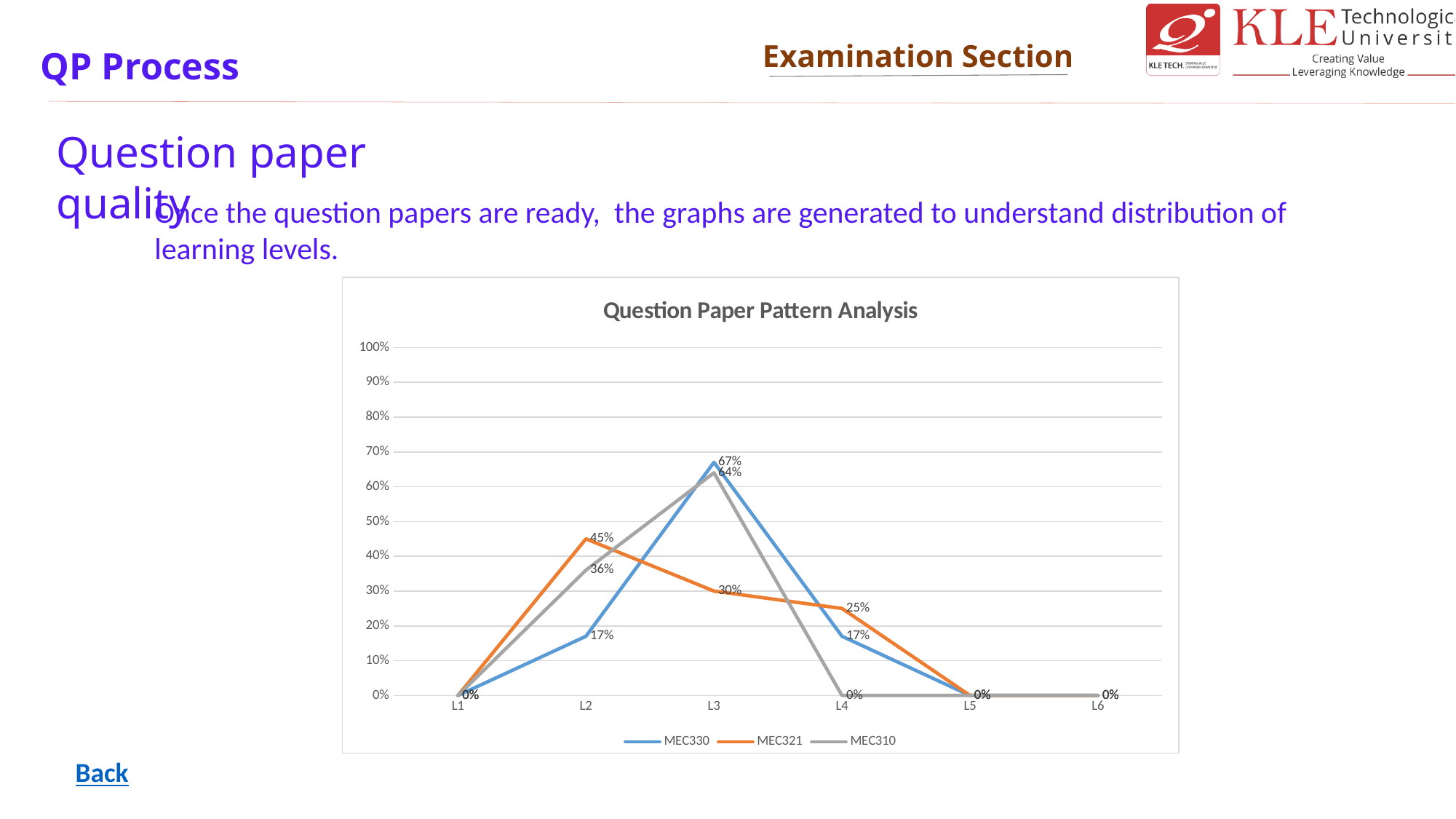
What is the value for MEC310 at L2? 36% How many series does the legend of the Question Paper Pattern Analysis chart list? 3 What is the value for MEC330 at L3? 67% At which learning level does MEC330 reach its highest value? L3 At L2, which series has the larger value, MEC321 or MEC330? MEC321 What is the value for MEC321 at L2? 45% What is the title of the chart? Question Paper Pattern Analysis What kind of chart is shown on the slide? line chart What is the difference between the MEC321 value and the MEC330 value at L2? 28% How many learning levels are shown on the x axis of the chart? 6 What is the value for MEC310 at L4? 0% What is the value for MEC321 at L4? 25%